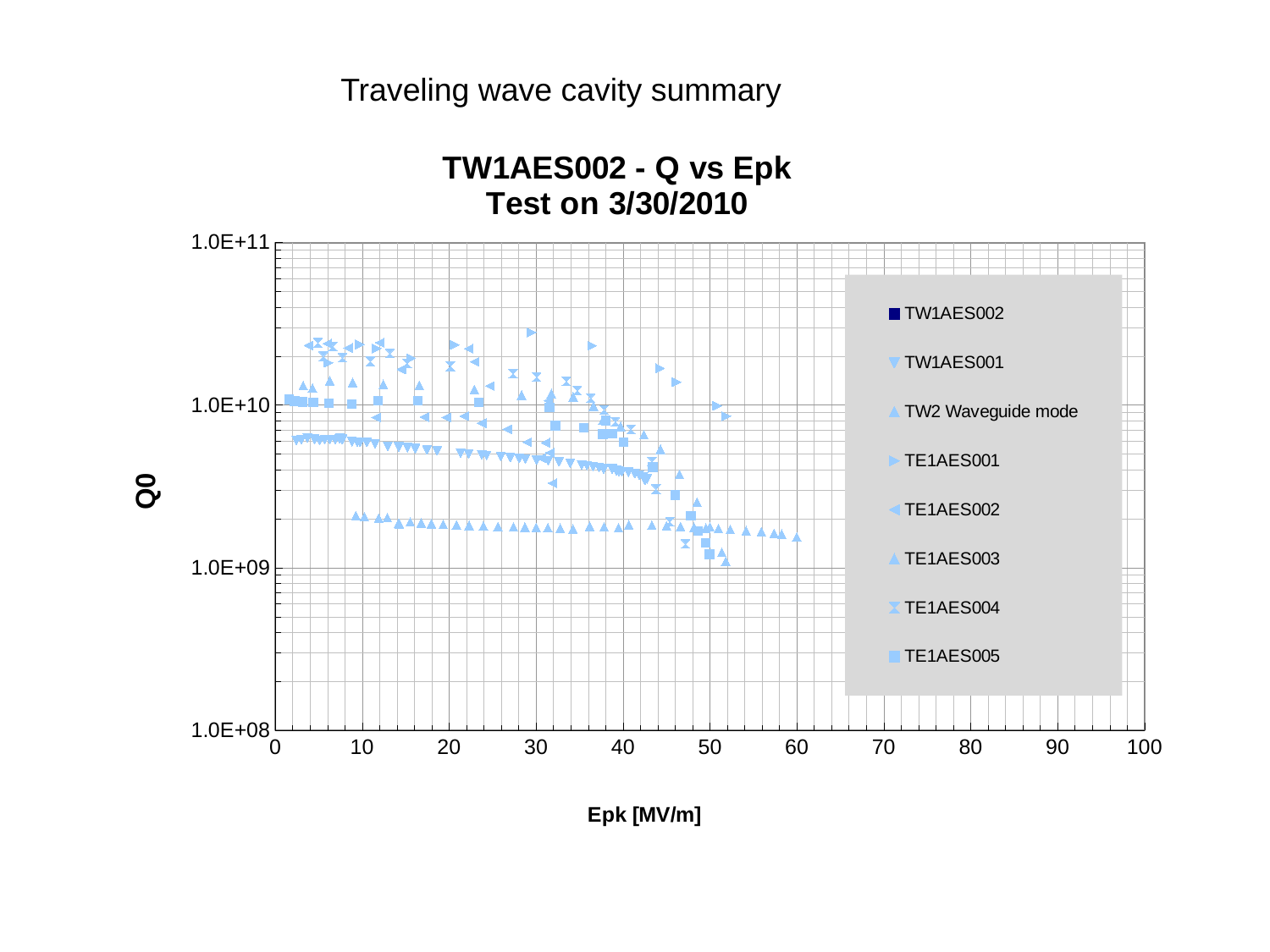
What is the title of the chart? TW1AES002 - Q vs Epk Test on 3/30/2010 What is the label of the x axis? Epk [MV/m] What kind of chart is shown on the slide? scatter chart What is the highest value shown on the y axis? 1.0E+11 Overall, do the plotted Q0 values rise or fall as Epk increases beyond about 40 MV/m? fall Is the largest Epk value at which any point is plotted greater or less than 70? less What is the maximum value shown on the x axis? 100 Is the highest plotted Q0 value greater or less than 1.0E+11? less What is the lowest value shown on the y axis? 1.0E+08 What is the label of the y axis? Q0 Which legend entry is listed first? TW1AES002 How many series does the legend list? 8